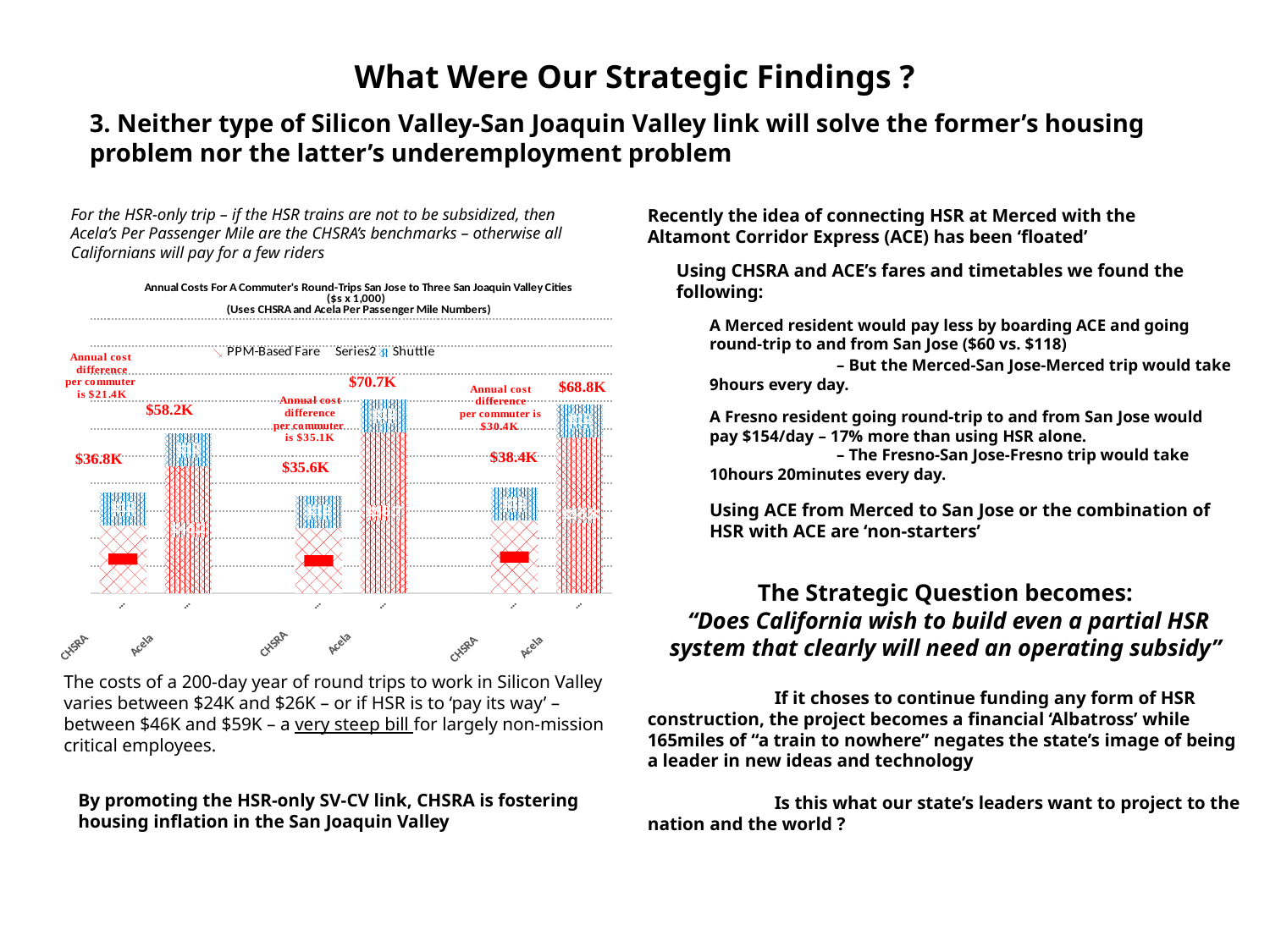
How many series does the chart's legend list? 3 Which bar has the lowest labeled total annual cost? CHSRA in the middle group ($35.6K) Which bar has the highest labeled total annual cost? Acela in the middle group ($70.7K) What is the total annual cost labeled on the CHSRA bar in the third (rightmost) group? $38.4K In the third (rightmost) group, which bar is larger, CHSRA or Acela? Acela What is the difference between the Acela and CHSRA totals in the first (leftmost) group? $21.4K What is the total annual cost labeled on the CHSRA bar in the first (leftmost) group? $36.8K What is the total annual cost labeled on the Acela bar in the first (leftmost) group? $58.2K What kind of chart is shown on the slide? Stacked bar chart What are the three legend entries of the chart? PPM-Based Fare, Series2, Shuttle How many bars are plotted in the chart? 6 What is the total annual cost labeled on the Acela bar in the middle group? $70.7K